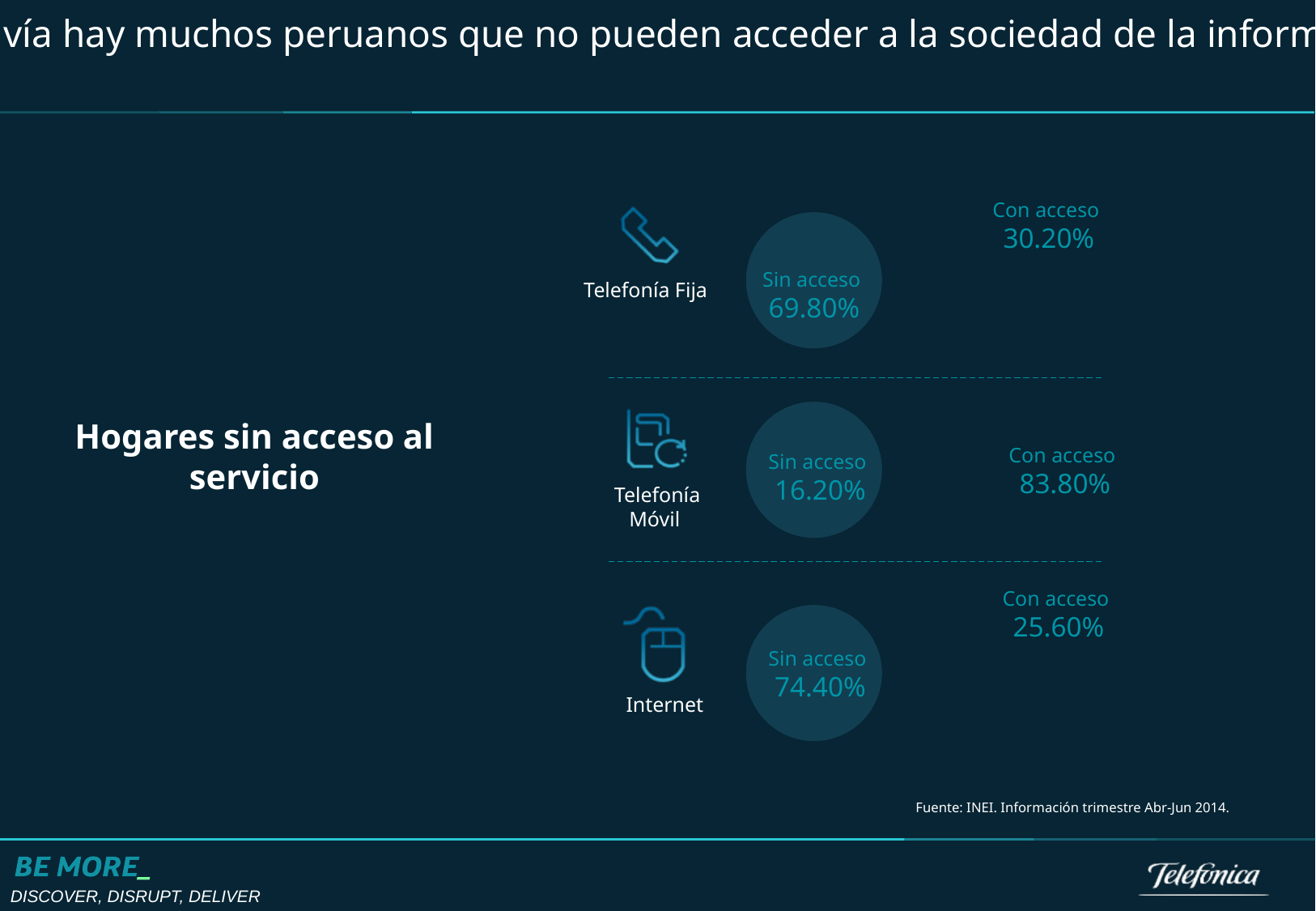
Across the three charts, which service has the highest 'Sin acceso' percentage? Internet What is the source cited for the data on the slide? INEI. Información trimestre Abr-Jun 2014. In the Internet chart, what percentage of households are 'Con acceso'? 25.60% In the Telefonía Fija chart, what percentage of households are 'Sin acceso'? 69.80% What is the difference between the 'Sin acceso' percentage for Internet and for Telefonía Fija? 4.60% In the Internet chart, what percentage of households are 'Sin acceso'? 74.40% In the Telefonía Móvil chart, what percentage of households are 'Con acceso'? 83.80% In the Telefonía Móvil chart, what percentage of households are 'Sin acceso'? 16.20% In the Telefonía Fija chart, what percentage of households are 'Con acceso'? 30.20% Which is larger: the 'Con acceso' percentage for Telefonía Fija or for Internet? Telefonía Fija How many services (charts) are shown on the slide? 3 Across the three charts, which service has the lowest 'Sin acceso' percentage? Telefonía Móvil